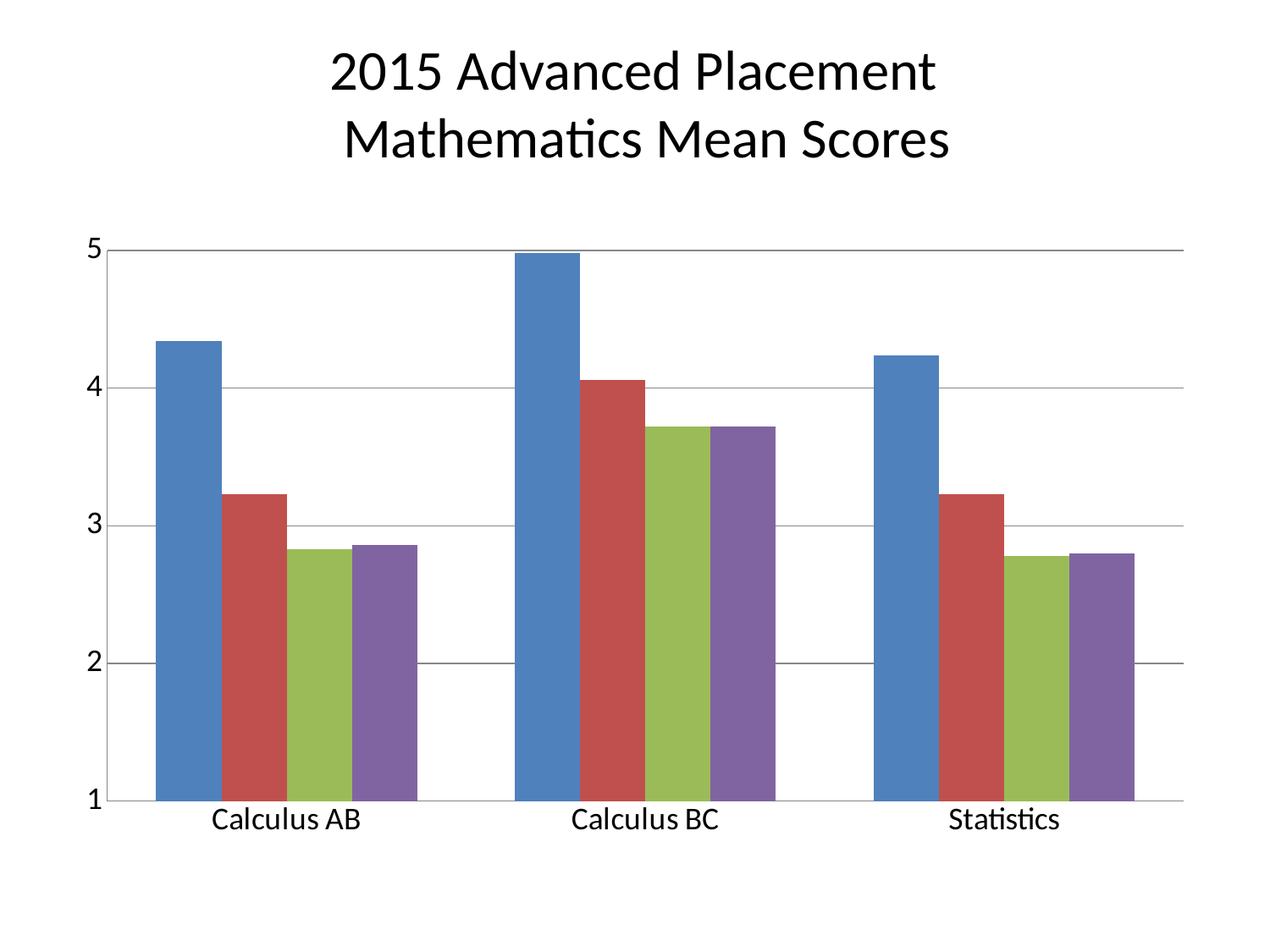
What kind of chart is shown on the slide? bar chart Is the green bar for Statistics greater or less than 3? less Within the Calculus AB category, which coloured bar is the tallest? blue How many bars are plotted for each category? 4 Is the red bar for Calculus AB greater or less than 4? less Which is larger, the red bar for Calculus BC or the red bar for Statistics? Calculus BC Which category has the tallest blue bar? Calculus BC How many categories are shown on the x axis? 3 Is the purple bar for Calculus BC greater or less than 3? greater Which category has the lowest green bar? Statistics What is the title of the chart? 2015 Advanced Placement Mathematics Mean Scores